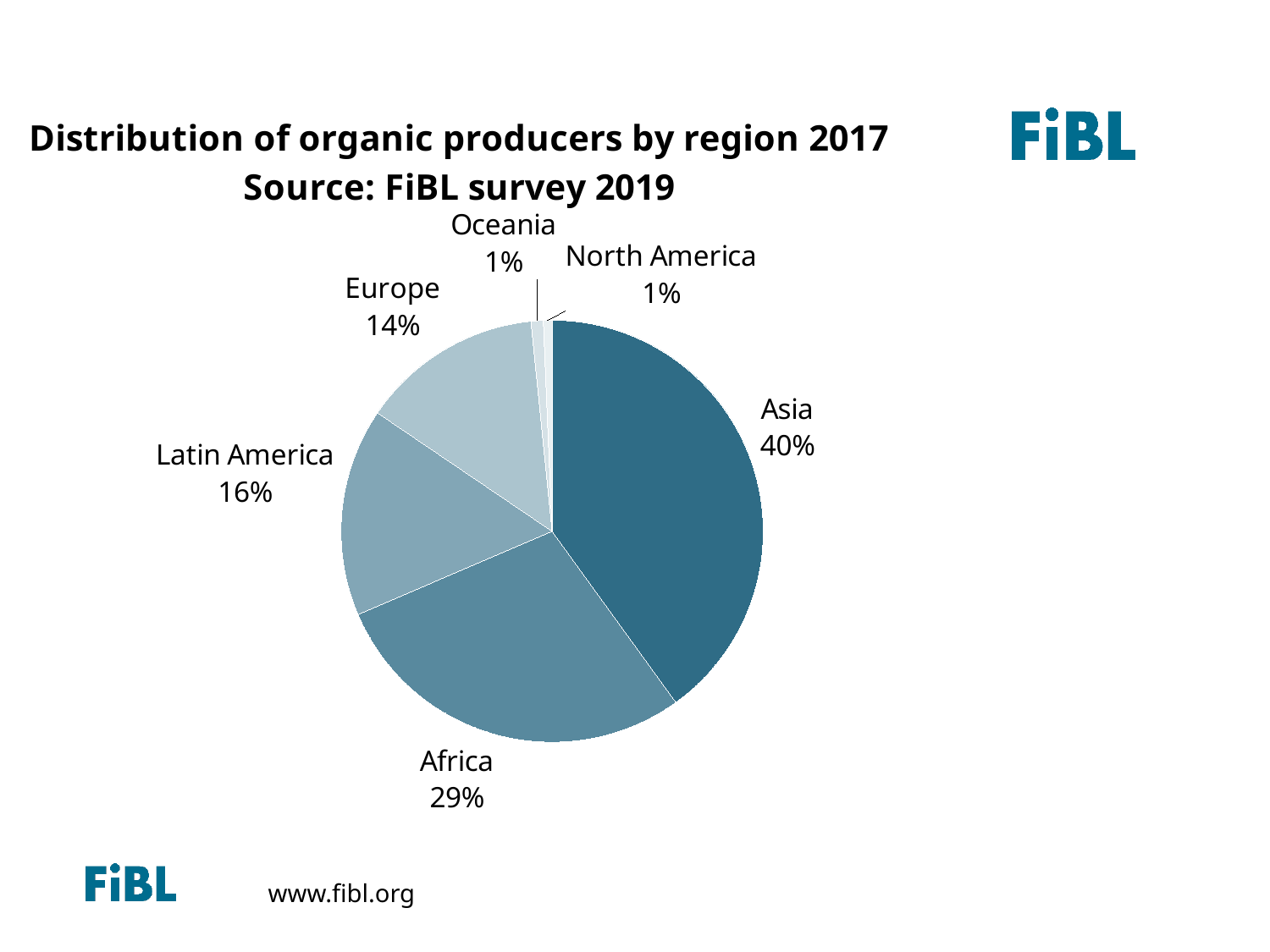
How many regions are shown in the pie chart? 6 What share of organic producers is in Europe? 14% Which has a larger share of organic producers, Latin America or Europe? Latin America What is the difference in percentage points between Asia's and Africa's shares? 11 What share of organic producers is in Asia? 40% What source is cited for the chart data? FiBL survey 2019 What share of organic producers is in Latin America? 16% What share of organic producers is in Africa? 29% Which region has the largest share of organic producers? Asia What is the title of the chart? Distribution of organic producers by region 2017 What is the combined share of Asia and Africa? 69% What kind of chart is shown on the slide? pie chart